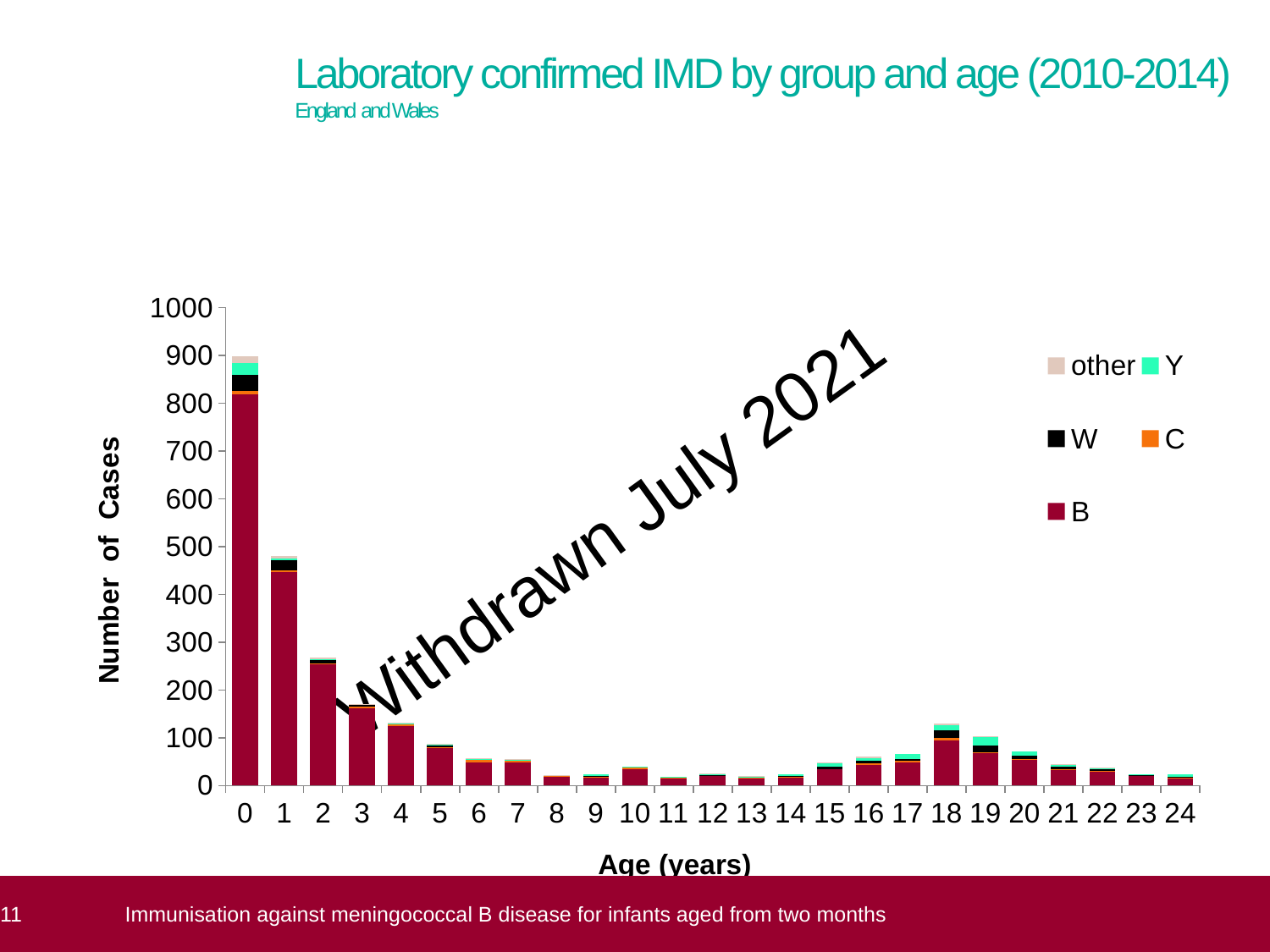
Is the total number of cases for age 3 greater or less than 200? less Which age has the highest total number of cases? 0 How many age categories are shown on the x axis? 25 What is the label of the y axis? Number of Cases Is the total number of cases for age 18 greater or less than 100? greater Which series makes up the largest part of each bar? B Is the total number of cases for age 1 greater or less than 400? greater Do the total cases rise or fall from age 0 to age 8? fall What kind of chart is shown on the slide? stacked bar chart Which has more total cases, age 1 or age 2? age 1 How many series does the legend list? 5